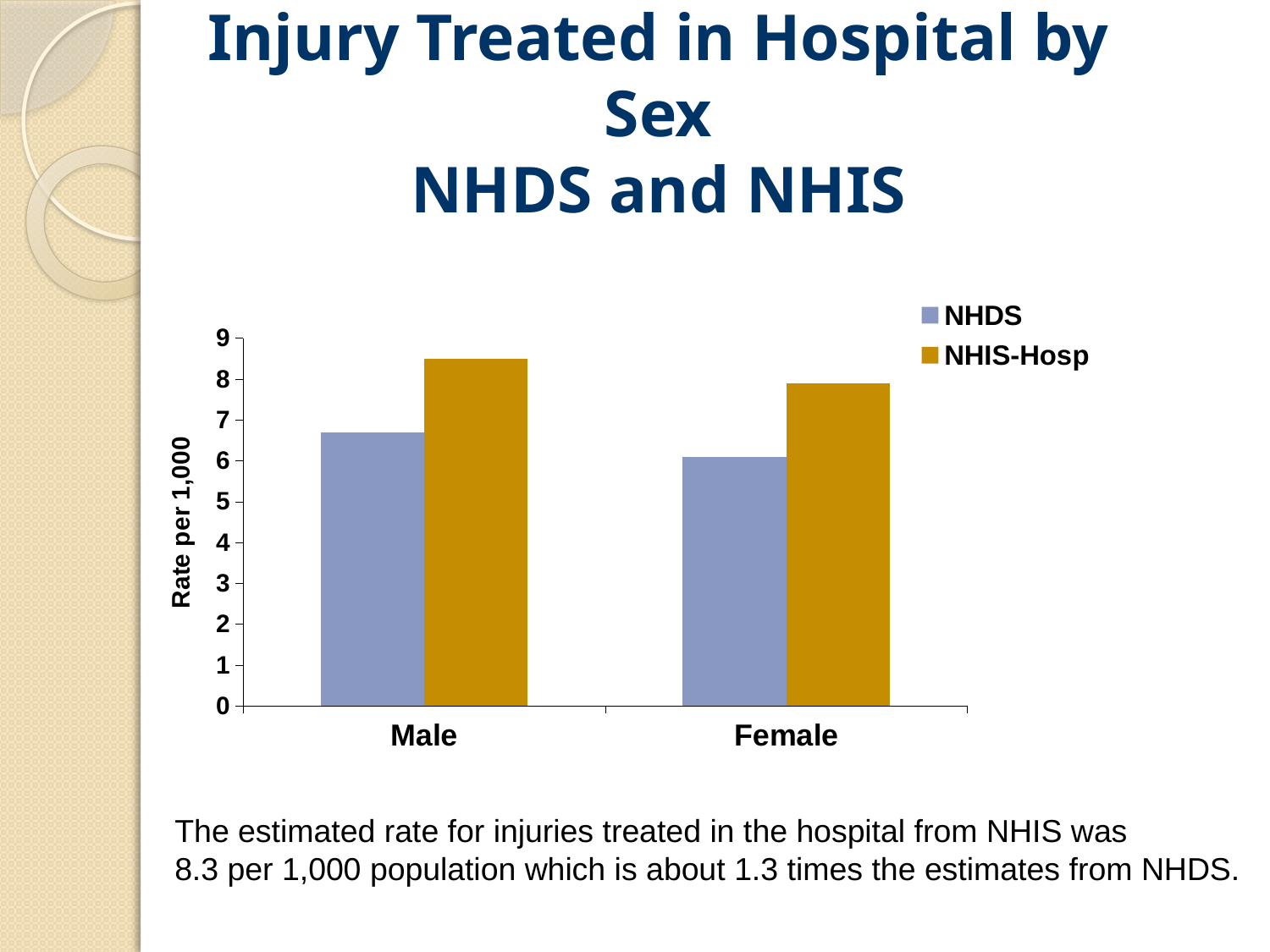
Which bar is the lowest in the chart? NHDS for Female What is the label of the y axis? Rate per 1,000 For Female, which series has the larger value, NHDS or NHIS-Hosp? NHIS-Hosp How many series does the legend list? 2 Is the NHIS-Hosp value for Male greater or less than 8? greater Which bar is the highest in the chart? NHIS-Hosp for Male How many categories are shown on the x axis? 2 What kind of chart is shown on the slide? bar chart Which is larger, the NHDS value for Male or the NHDS value for Female? Male Is the NHDS value for Female greater or less than 7? less Is the NHIS-Hosp value for Female greater or less than 7? greater